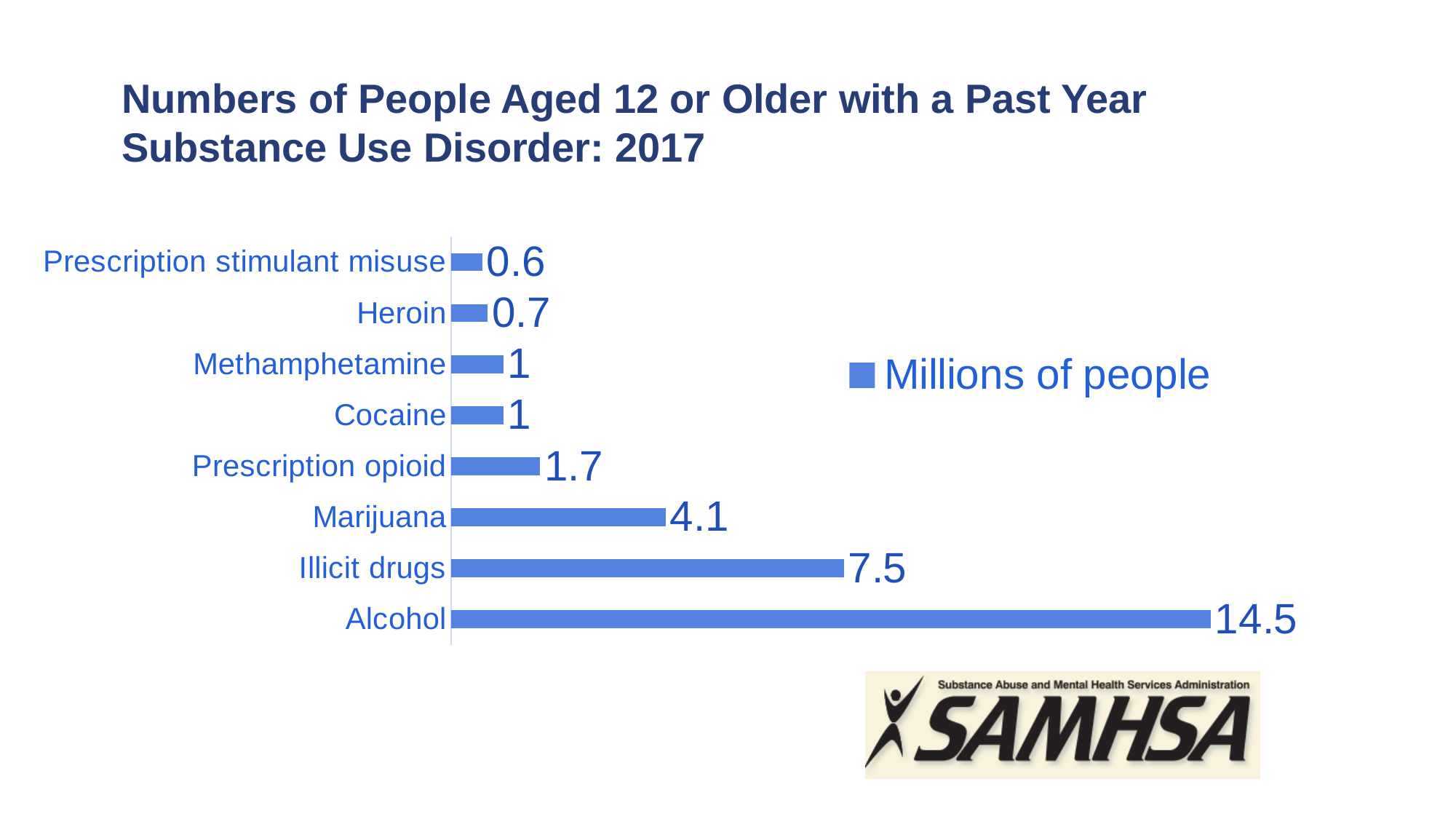
Which is larger, the value for Illicit drugs or the value for Marijuana? Illicit drugs What is the value for Heroin? 0.7 What is the difference between the values for Marijuana and Prescription opioid? 2.4 How many categories are shown in the chart? 8 What is the value for Marijuana? 4.1 What kind of chart is shown on the slide? Bar chart What is the value for Prescription opioid? 1.7 What series name does the legend show? Millions of people Which category has the highest value? Alcohol Which category has the lowest value? Prescription stimulant misuse What is the value for Alcohol? 14.5 What is the difference between the values for Alcohol and Illicit drugs? 7